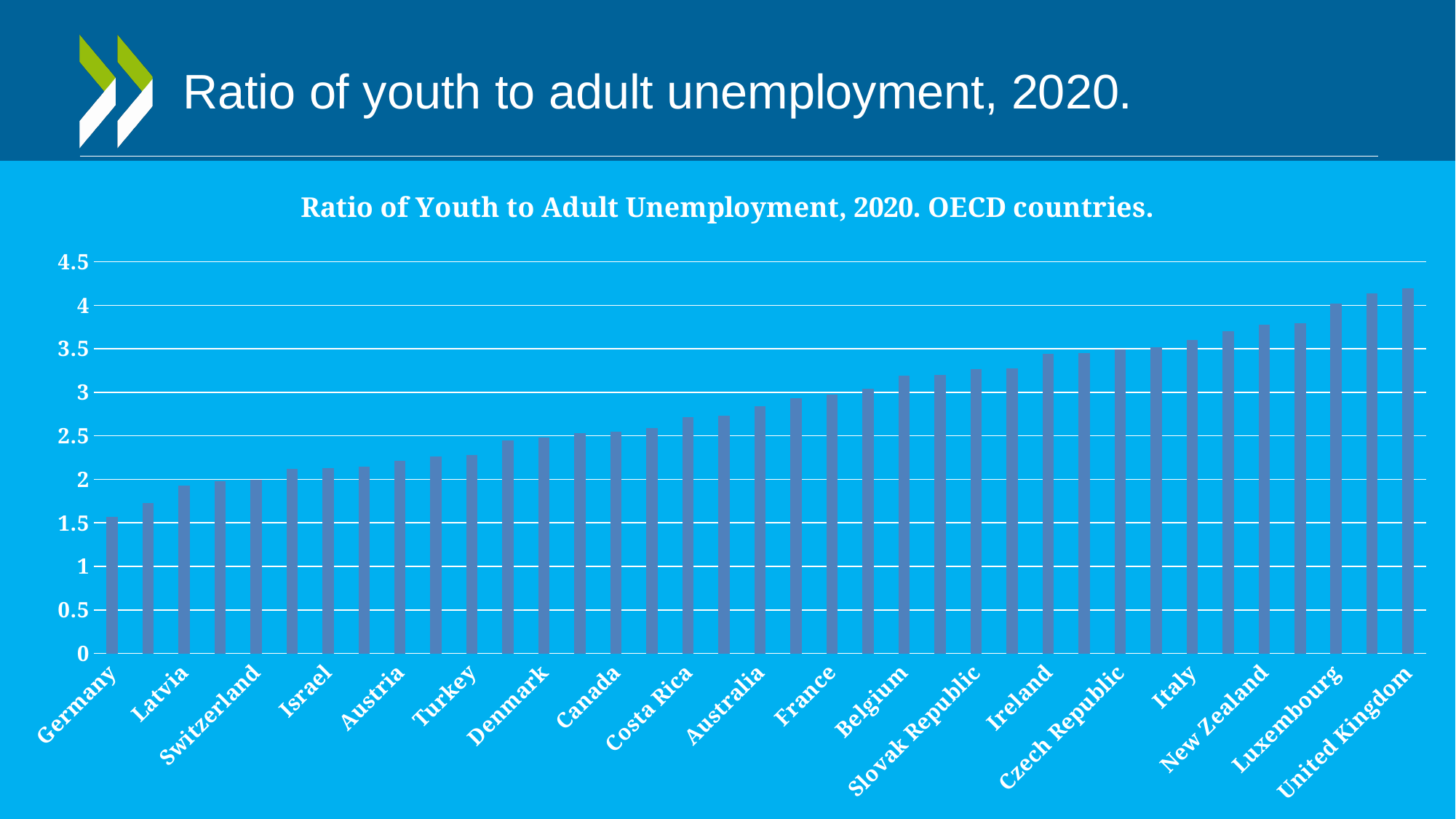
Which country has the highest ratio of youth to adult unemployment? United Kingdom Is the value for Germany greater or less than 2? less Is the value for Turkey greater or less than 2.5? less Do the values rise or fall moving from left to right along the x axis? rise Is the value for Australia greater or less than 2.5? greater Which is larger, the value for Italy or the value for Austria? Italy Which country has the lowest ratio of youth to adult unemployment? Germany What is the title of the chart? Ratio of Youth to Adult Unemployment, 2020. OECD countries. What kind of chart is shown on the slide? bar chart